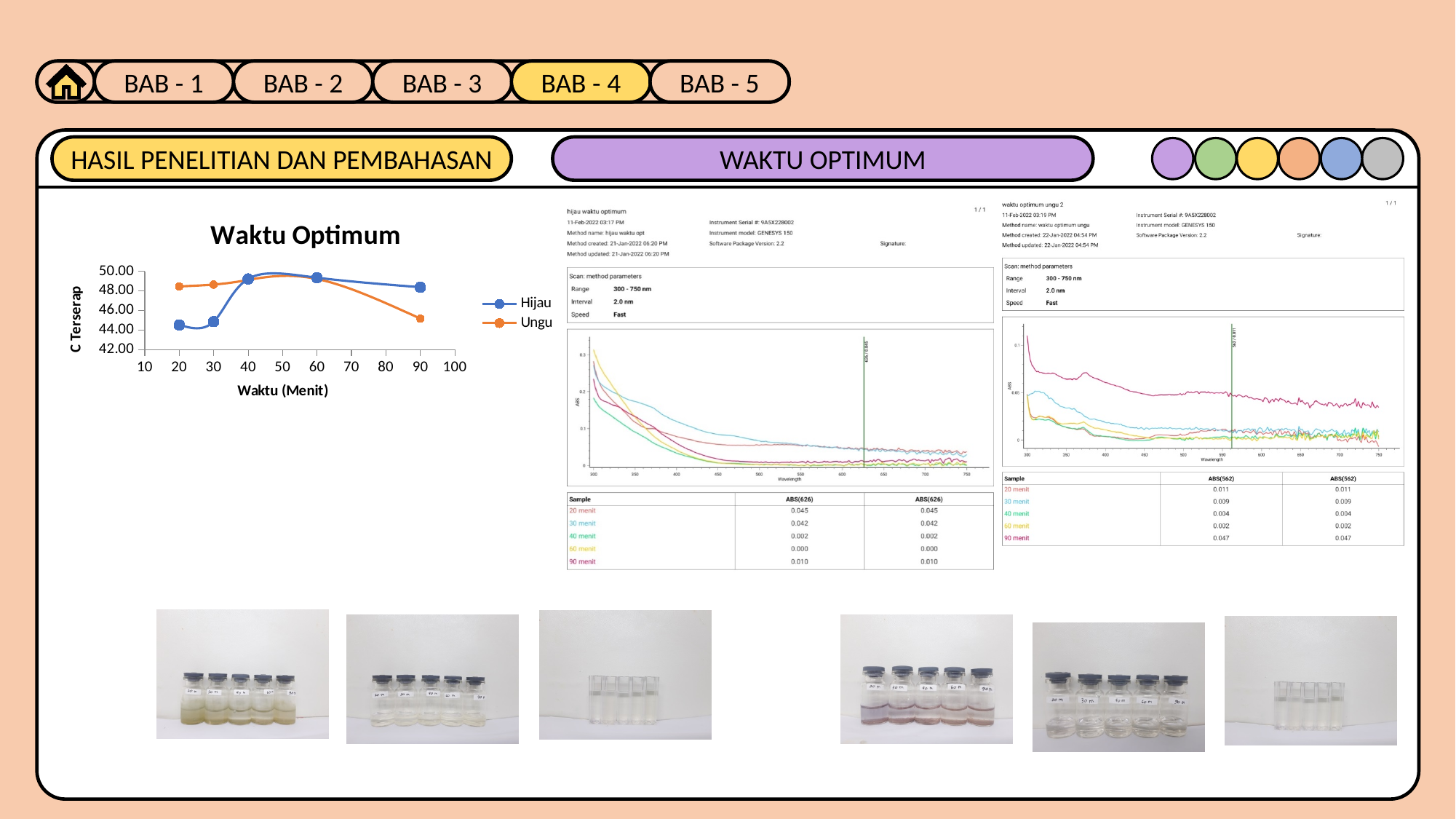
What is the x-axis title of the 'Waktu Optimum' chart? Waktu (Menit) In the 'Waktu Optimum' chart, which series has the larger value at 90 minutes, Hijau or Ungu? Hijau How many series does the legend of the 'Waktu Optimum' chart list? 2 In the 'Waktu Optimum' chart, at which time (in minutes) is the Ungu series lowest? 90 In the 'Waktu Optimum' chart, is the Ungu value at 90 minutes greater or less than 46.00? less In the 'Waktu Optimum' chart, is the Ungu value at 20 minutes greater or less than 46.00? greater In the 'Waktu Optimum' chart, does the Ungu series rise or fall between 60 and 90 minutes? fall In the 'Waktu Optimum' chart, is the Hijau value at 20 minutes greater or less than 46.00? less In the 'Waktu Optimum' chart, which series has the larger value at 20 minutes, Hijau or Ungu? Ungu How many data points does the Hijau series have in the 'Waktu Optimum' chart? 5 What type of chart is the 'Waktu Optimum' chart on the left of the slide? line chart